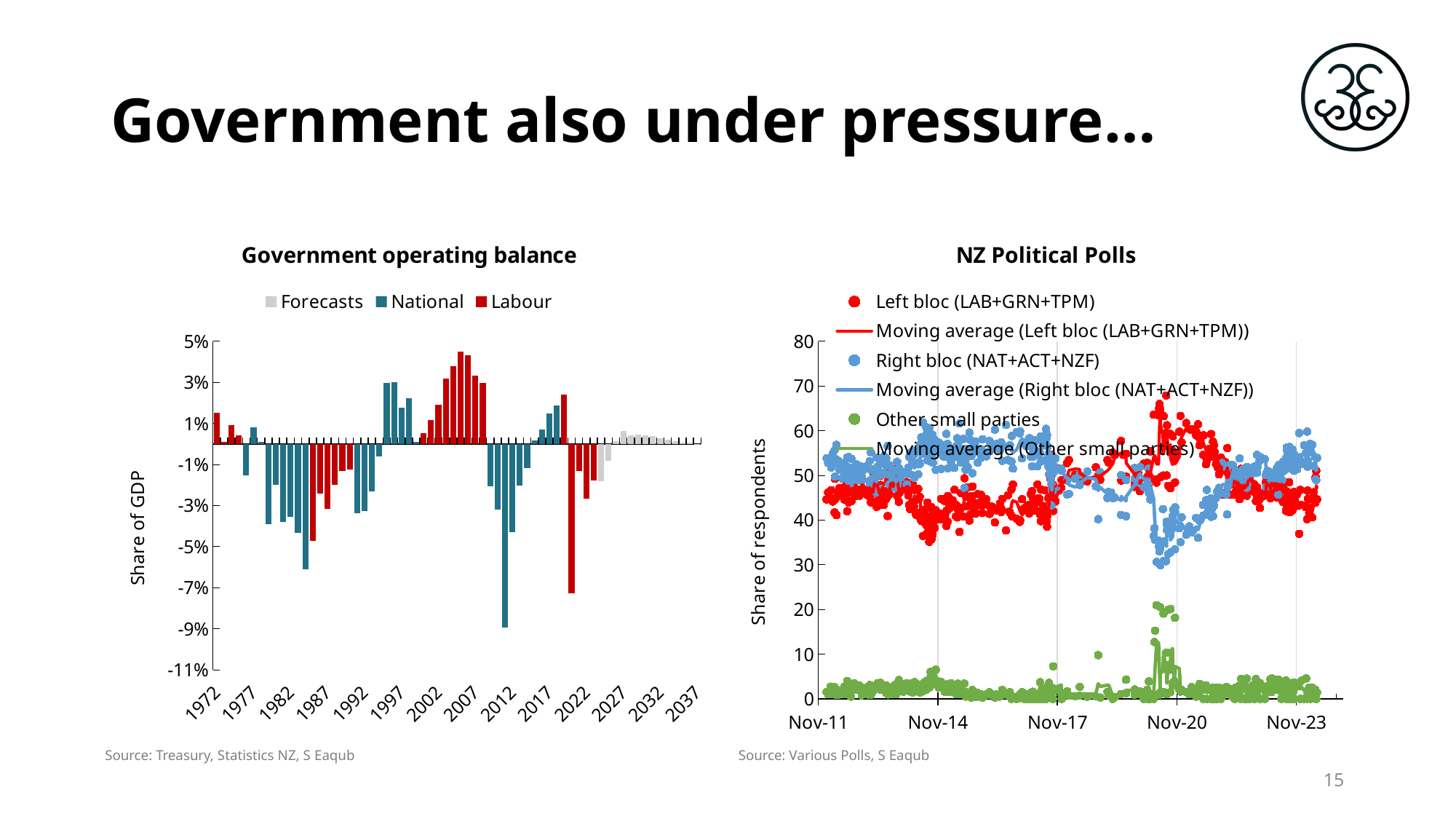
In the NZ Political Polls chart, at its lowest point around Nov-20, is the Right bloc (NAT+ACT+NZF) value greater or less than 40? less In the NZ Political Polls chart, around Nov-14, which is higher: the Left bloc (LAB+GRN+TPM) or the Right bloc (NAT+ACT+NZF)? Right bloc (NAT+ACT+NZF) In the NZ Political Polls chart, which series has the lowest values throughout the period? Other small parties How many series does the legend of the NZ Political Polls chart list? 6 What kind of chart is the Government operating balance chart? bar chart In the NZ Political Polls chart, is the peak value for Other small parties (around Nov-20) greater or less than 10? greater In the Government operating balance chart, is the highest bar (around 2006) greater or less than 3%? greater How many series does the legend of the Government operating balance chart list? 3 In the Government operating balance chart, which series is shown in grey? Forecasts In the NZ Political Polls chart, does the Right bloc (NAT+ACT+NZF) moving average rise or fall between Nov-20 and Nov-23? rise What is the y-axis label of the Government operating balance chart? Share of GDP